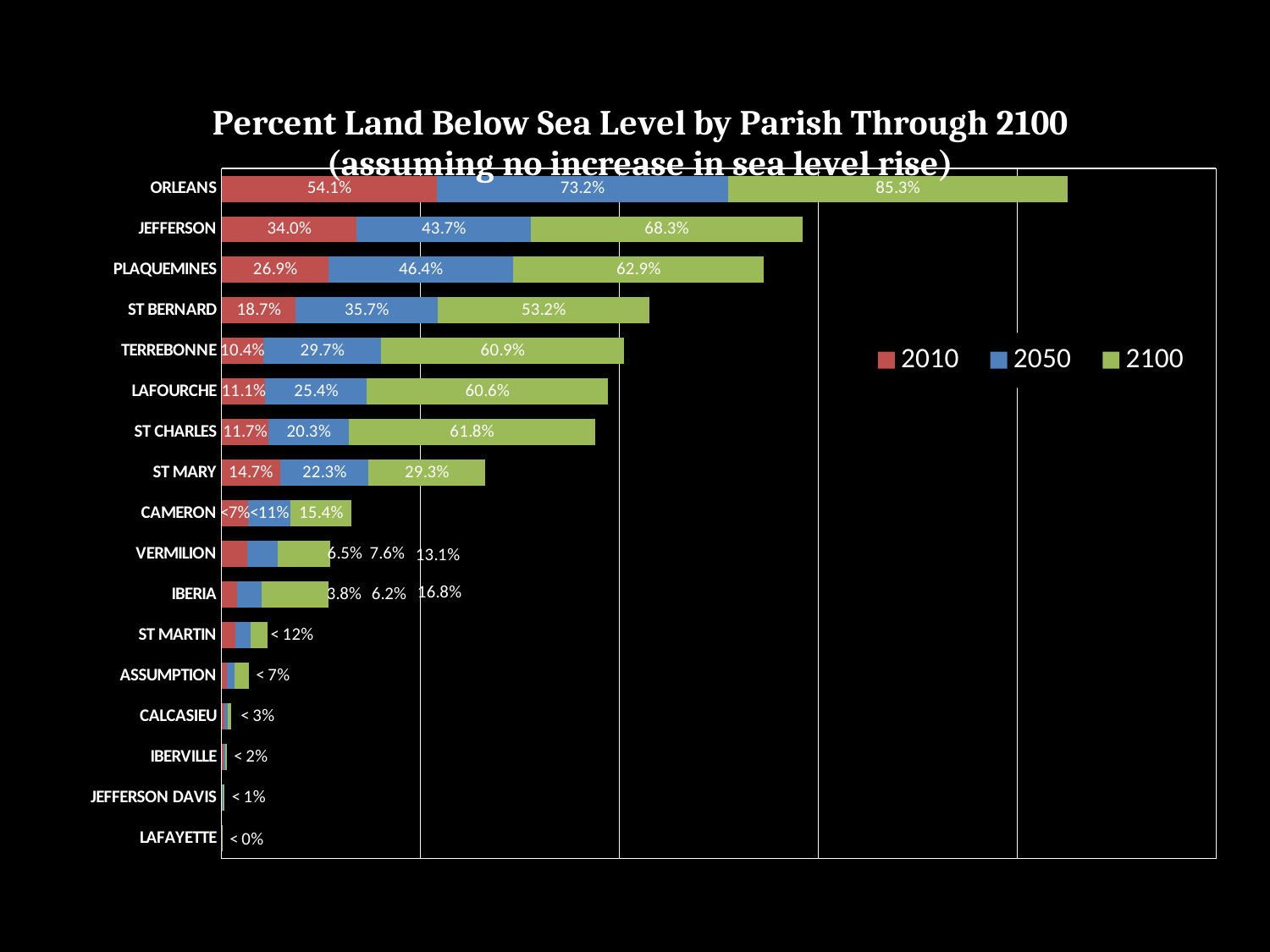
How many series does the legend list? 3 Which is larger, the 2050 value for St Bernard or the 2050 value for Terrebonne? St Bernard What is the 2100 value for St Bernard? 53.2% What is the 2100 value for Orleans? 85.3% Which parish has the highest 2100 value? Orleans What are the three series listed in the legend? 2010, 2050, 2100 What is the 2010 value for Jefferson? 34.0% What is the difference between the 2100 and 2010 values for Orleans? 31.2 percentage points What is the 2050 value for Terrebonne? 29.7% What kind of chart is this? Stacked bar chart How many parishes are shown on the chart? 17 What is the 2050 value for Plaquemines? 46.4%